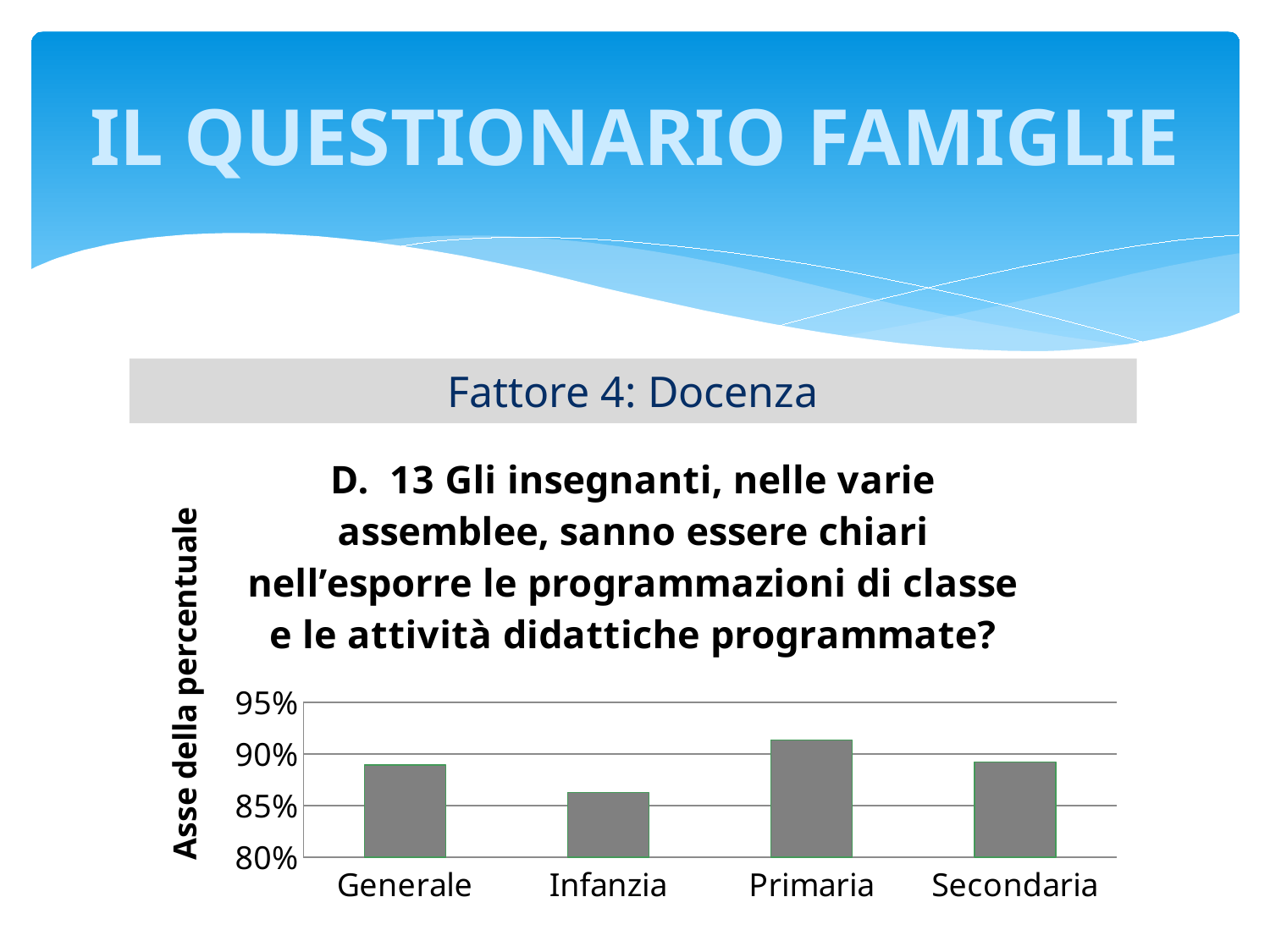
Is the value for Generale greater or less than 90%? less Is the value for Primaria greater or less than 90%? greater Is the value for Infanzia greater or less than 85%? greater Which category has the highest value in the chart? Primaria What is the title of the vertical axis of the chart? Asse della percentuale How many categories are shown on the x axis of the chart? 4 Which category has the lowest value in the chart? Infanzia Which is larger, the value for Generale or the value for Infanzia? Generale Which is larger, the value for Primaria or the value for Infanzia? Primaria What kind of chart is shown on the slide? bar chart